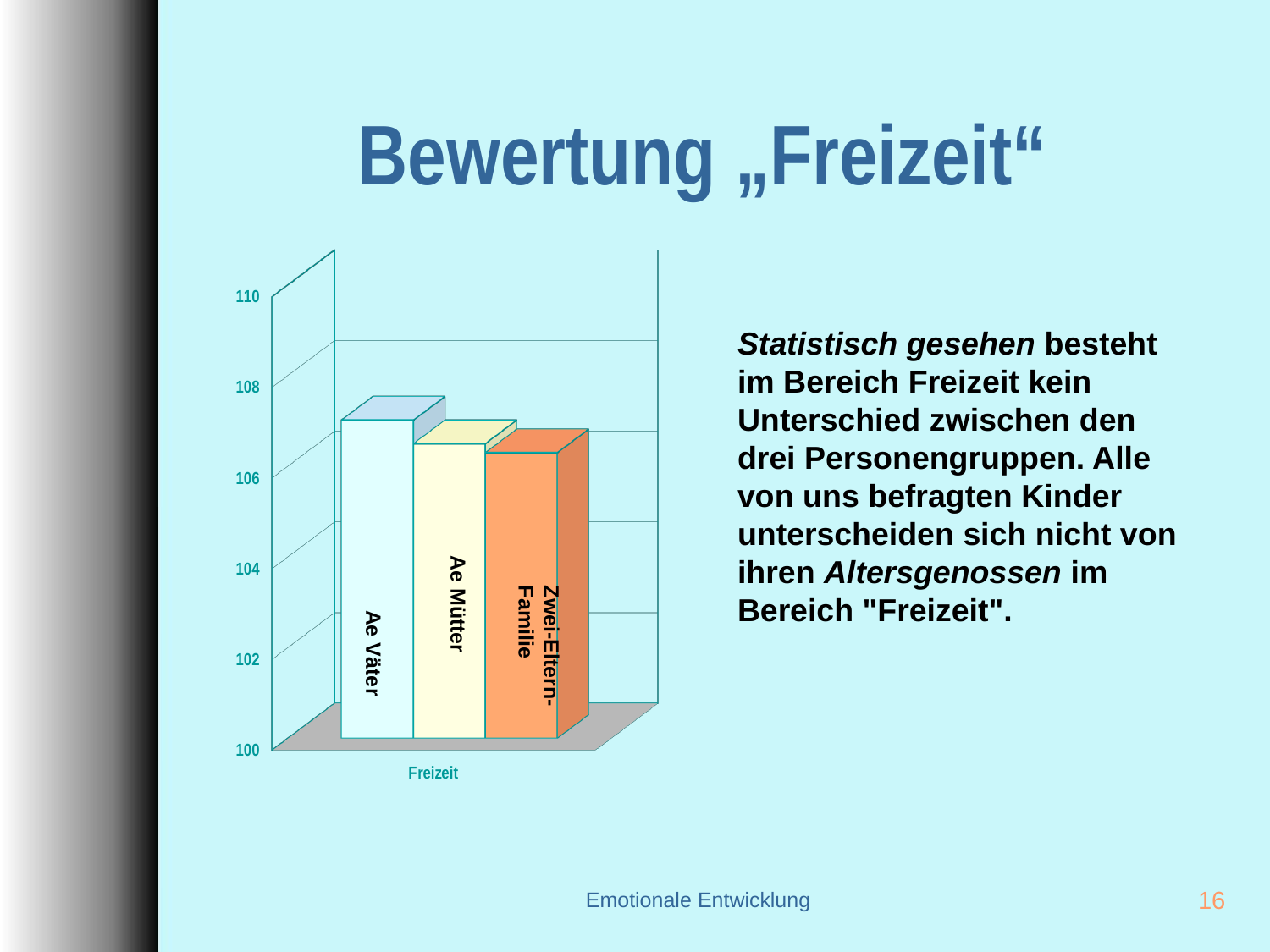
Is the value for Ae Mütter greater or less than 108? less Is the value for Ae Väter greater or less than 108? less Which group has the highest bar in the chart? Ae Väter Which is larger, the value for Ae Väter or the value for Zwei-Eltern-Familie? Ae Väter Is the value for Ae Mütter greater or less than 104? greater What is the title of the slide containing the chart? Bewertung „Freizeit“ How many bars are plotted in the chart? 3 What label is shown on the category axis below the bars? Freizeit What kind of chart is shown on the slide? bar chart Which is larger, the value for Ae Väter or the value for Ae Mütter? Ae Väter